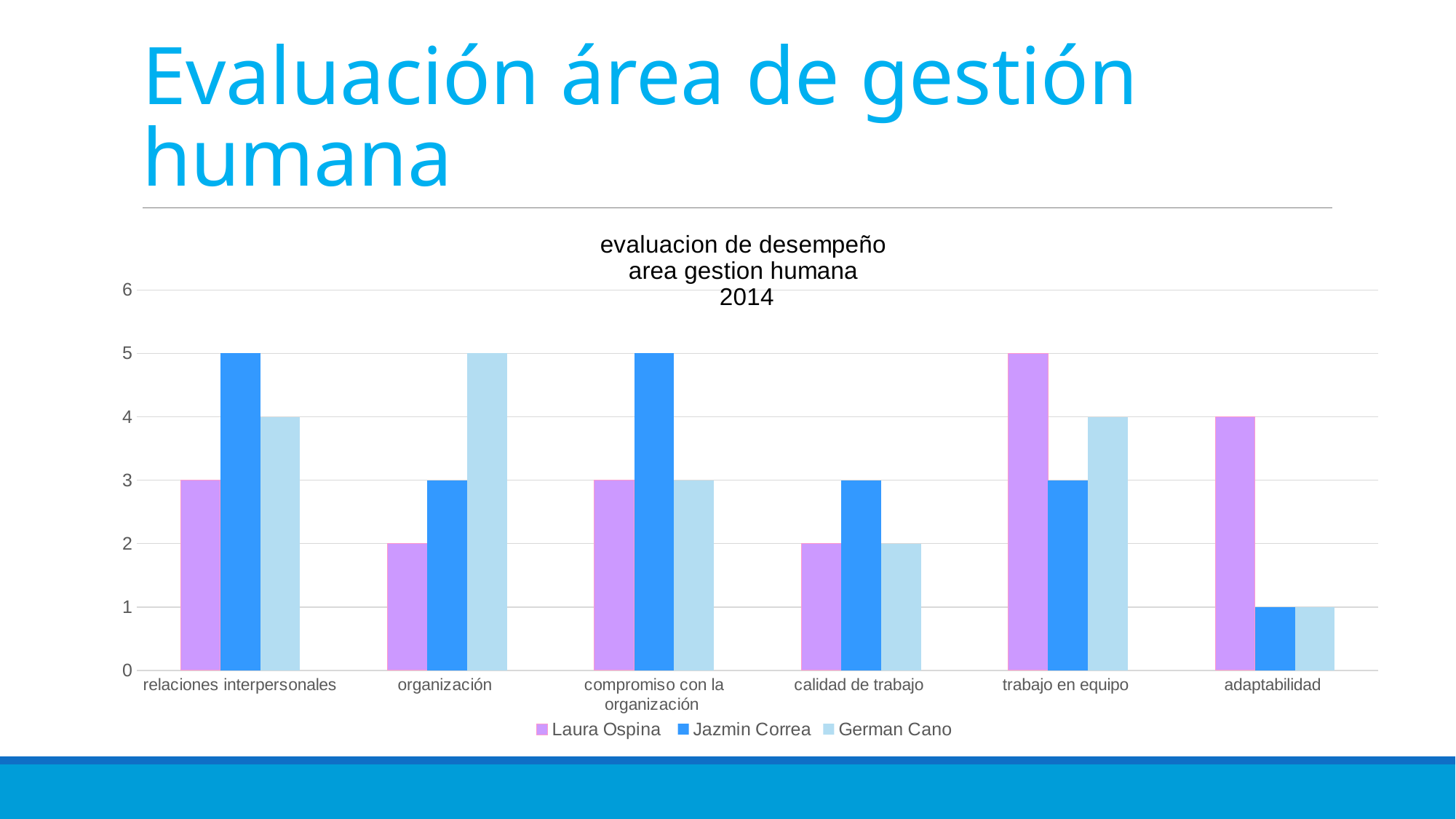
What is the value for German Cano in organización? 5 Which is larger in calidad de trabajo: Jazmin Correa or German Cano? Jazmin Correa Which series has the lowest value in organización? Laura Ospina What is the value for Laura Ospina in adaptabilidad? 4 How many categories are shown on the x axis? 6 How many series does the legend list? 3 What is the difference between Jazmin Correa and Laura Ospina in compromiso con la organización? 2 Which series has the highest value in trabajo en equipo? Laura Ospina What year is shown in the chart title? 2014 Is the value for Laura Ospina in trabajo en equipo greater or less than 4? greater What is the value for Jazmin Correa in relaciones interpersonales? 5 What type of chart is shown on the slide? bar chart